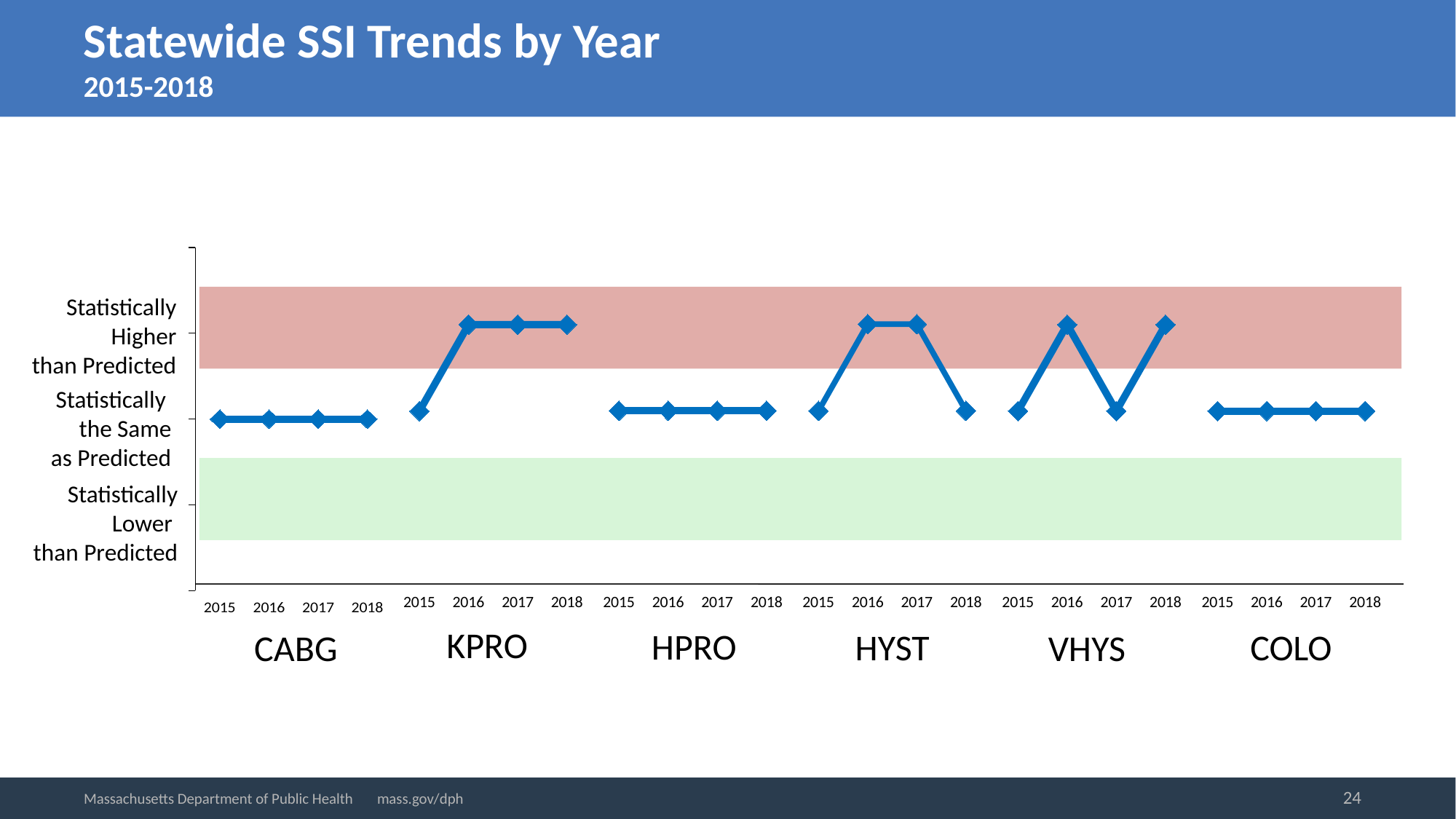
In which category does the VHYS point for 2017 fall? Statistically the Same as Predicted In which category does the KPRO point for 2016 fall? Statistically Higher than Predicted How many years are plotted for each procedure group in the chart? 4 What kind of chart is shown on the slide? line chart In which category does the CABG point for 2018 fall? Statistically the Same as Predicted How does the KPRO line change from 2015 to 2016? rises Which procedure groups have all four years in the Statistically the Same as Predicted band? CABG, HPRO, COLO In which category does the VHYS point for 2018 fall? Statistically Higher than Predicted In which category does the HYST point for 2018 fall? Statistically the Same as Predicted Do any points in the chart fall in the Statistically Lower than Predicted band? No How many procedure groups are shown along the x axis of the chart? 6 How does the HYST line change from 2017 to 2018? falls